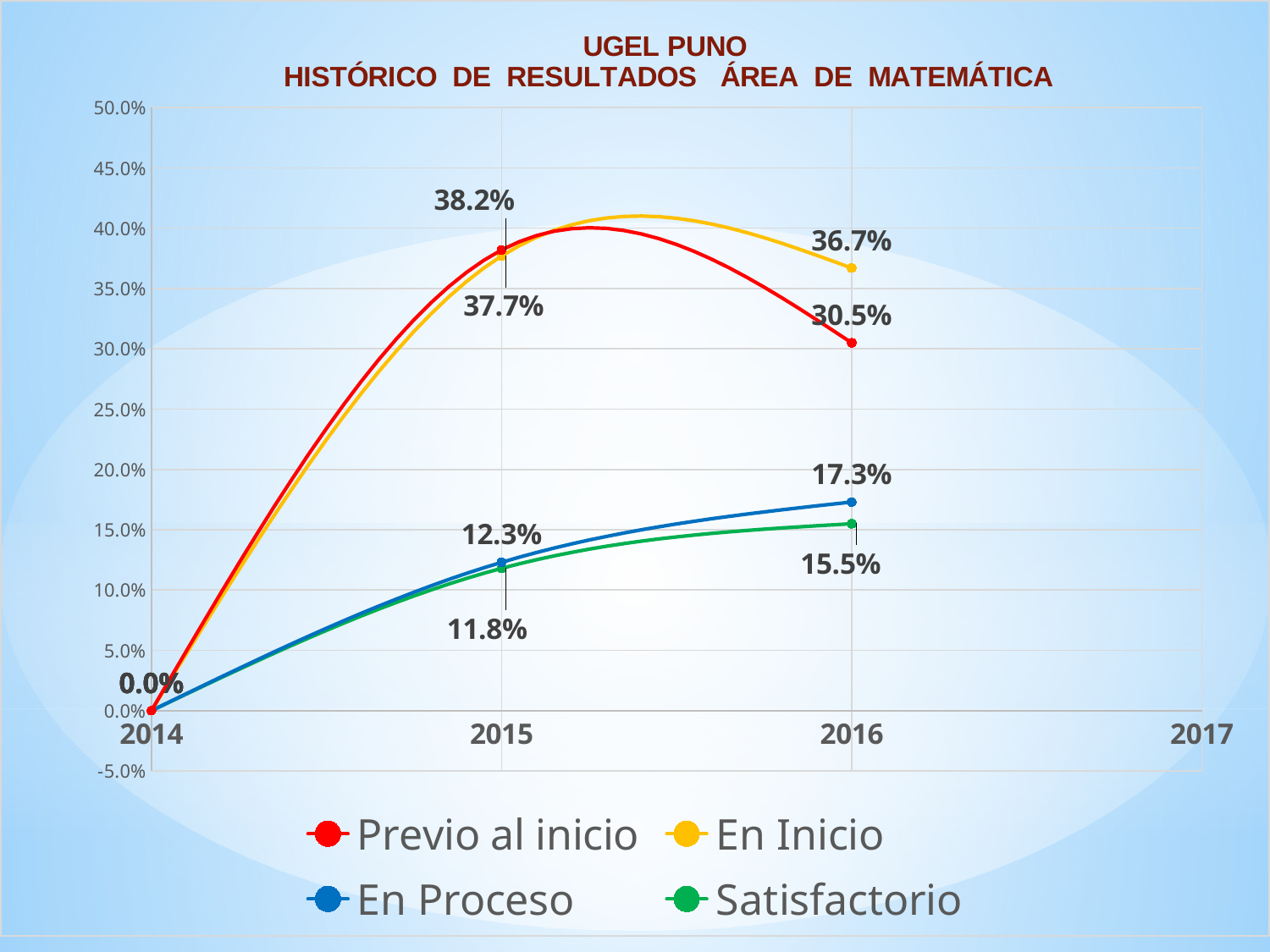
What type of chart is shown on the slide? line chart Which series has the highest value in 2016? En Inicio Does the Previo al inicio series rise or fall from 2015 to 2016? fall What is the value for En Proceso in 2016? 17.3% Which is larger in 2015: the value for En Proceso or the value for Satisfactorio? En Proceso What is the value for Satisfactorio in 2015? 11.8% How many series does the legend list? 4 Which series has the lowest value in 2016? Satisfactorio What colour is the line for Satisfactorio? green What is the value for En Inicio in 2016? 36.7% What is the value for Previo al inicio in 2015? 38.2% What is the difference between the Previo al inicio values in 2015 and 2016? 7.7%